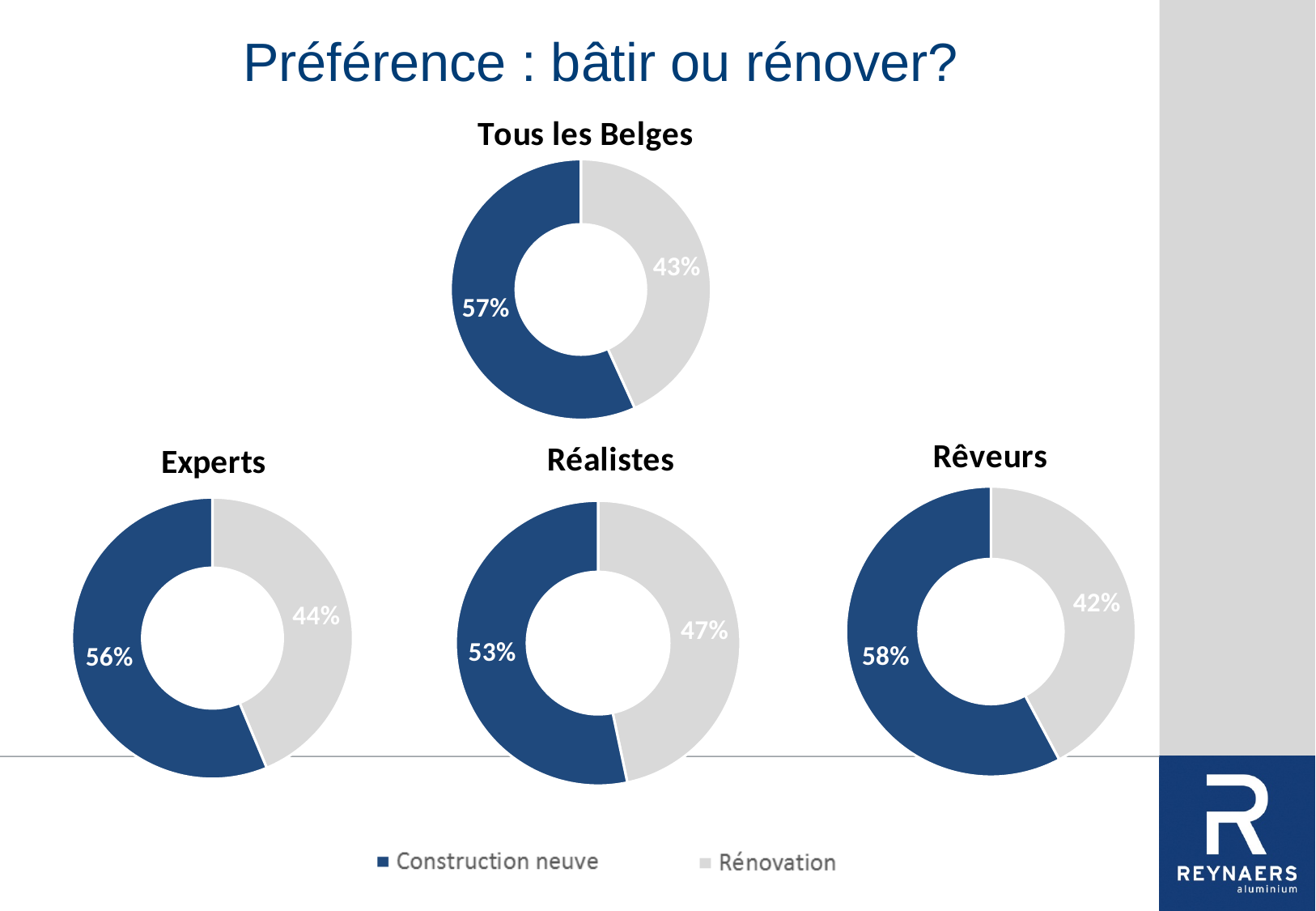
In the 'Tous les Belges' chart, what is the value for Construction neuve? 57% In the 'Rêveurs' chart, what is the value for Construction neuve? 58% In the 'Tous les Belges' chart, what is the value for Rénovation? 43% What kind of chart is the 'Rêveurs' chart? Doughnut chart In the 'Réalistes' chart, which slice is larger, Construction neuve or Rénovation? Construction neuve In the 'Réalistes' chart, what is the value for Construction neuve? 53% In the 'Experts' chart, what is the value for Rénovation? 44% How many entries does the legend at the bottom of the slide list? 2 How many slices does the 'Experts' chart have? 2 In the 'Rêveurs' chart, what is the value for Rénovation? 42% In the 'Tous les Belges' chart, what is the difference between Construction neuve and Rénovation? 14% In the 'Experts' chart, what is the difference between Construction neuve and Rénovation? 12%